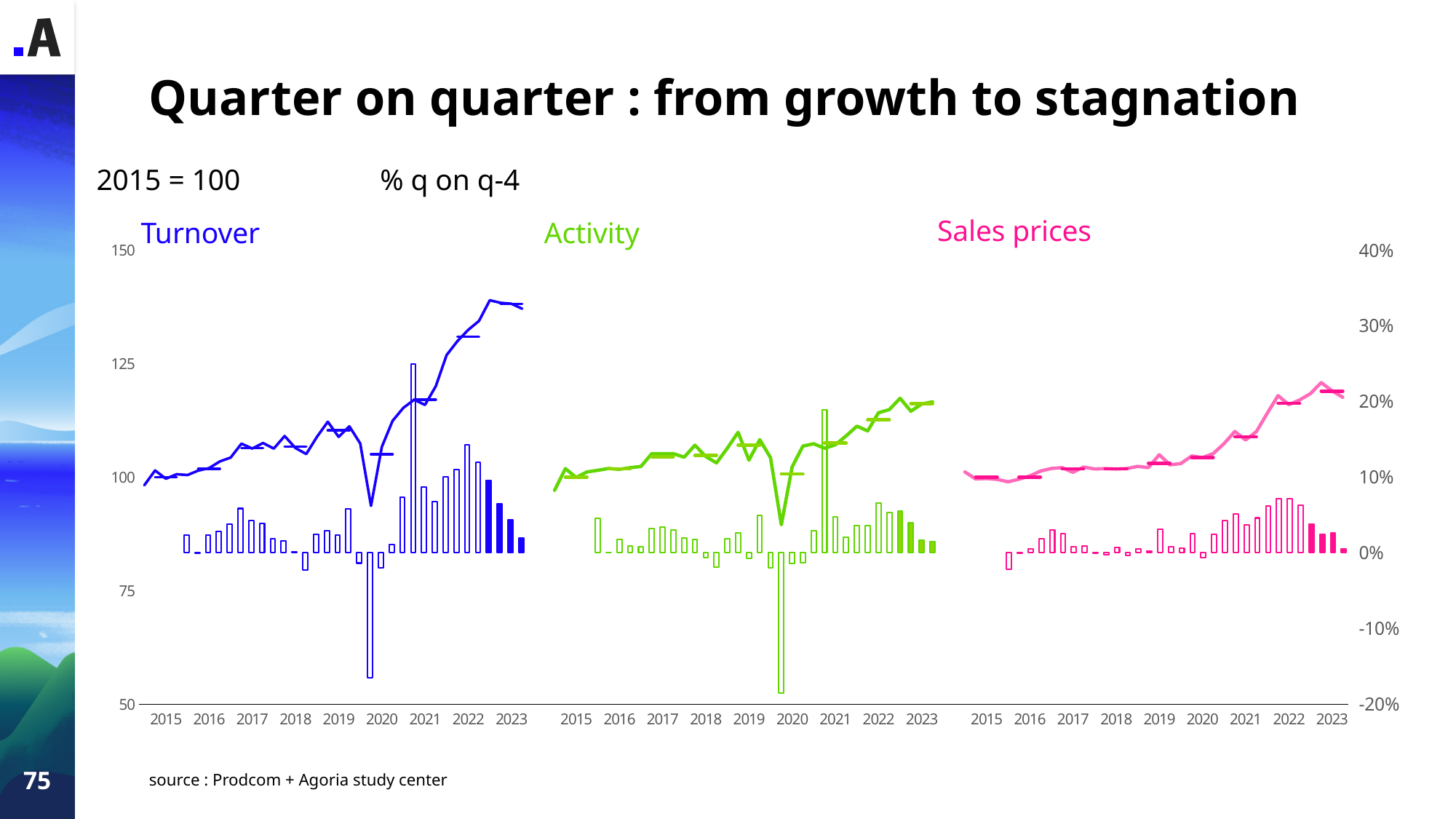
In the Turnover chart, how many years are labelled on the x axis? 9 What is the title of the slide containing the three charts? Quarter on quarter : from growth to stagnation In the Sales prices chart, does the line rise or fall from 2015 to 2023? Rises What kind of chart is the Turnover chart? Combined line and bar chart In the Activity chart, in which year do the bars reach their lowest value? 2020 In the Turnover chart, in which year do the bars reach their lowest value? 2020 In the Turnover chart, is the index line value in 2023 greater or less than 125? greater In the Turnover chart, does the index line rise or fall from 2015 to 2023? Rises In the Turnover chart, is the index line value in 2015 greater or less than 125? less In the Activity chart, is the lowest bar value greater or less than -10%? less How many charts are shown on the slide? 3 What colour is used for the Activity chart? Green